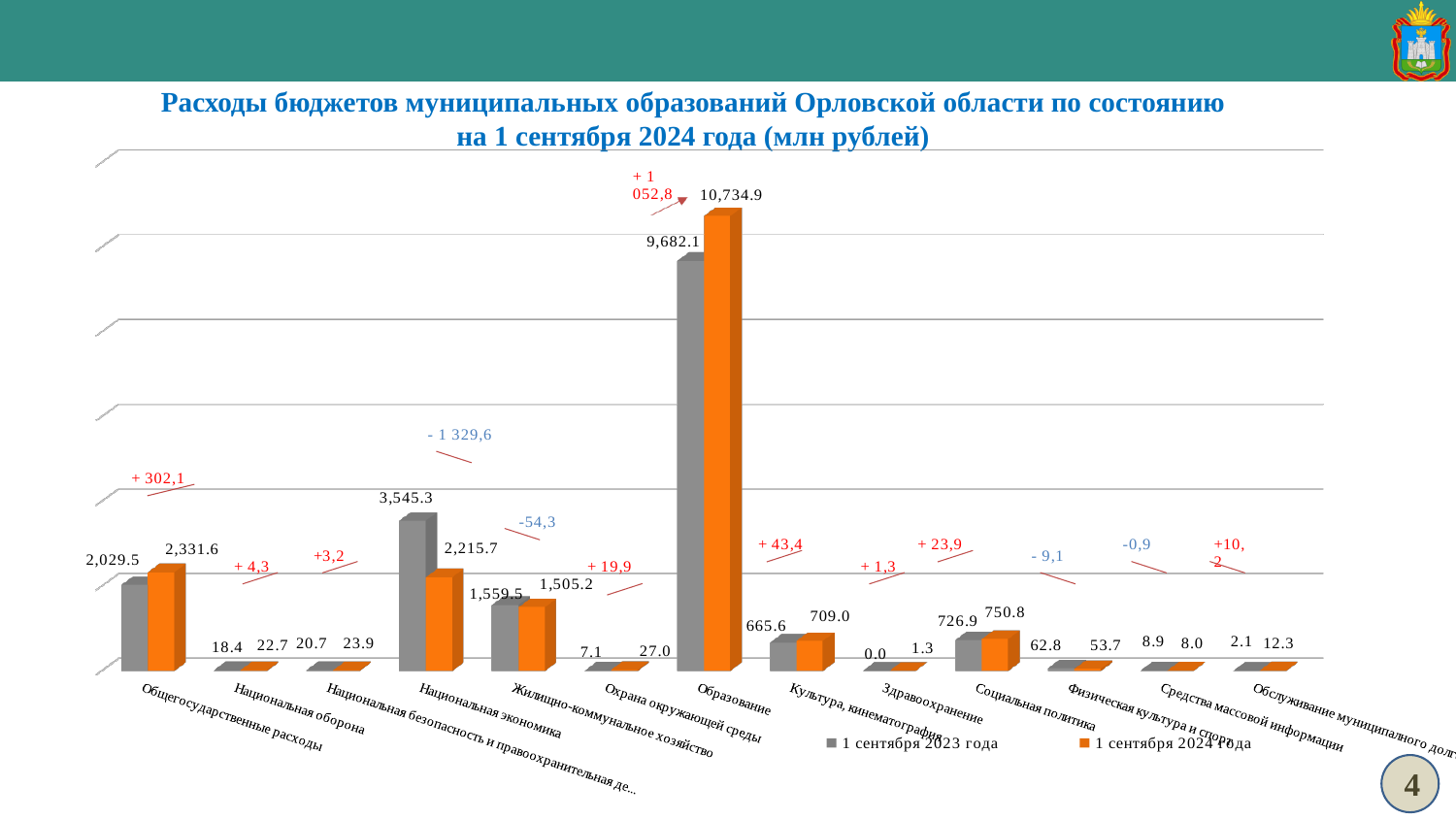
How many series does the legend list? 2 What is the difference between the 2023 and 2024 values for Национальная экономика? 1,329.6 What is the difference between the 2024 and 2023 values for Общегосударственные расходы? 302.1 What is the value for Образование for 1 сентября 2024 года? 10,734.9 Which is larger for Жилищно-коммунальное хозяйство: the 1 сентября 2023 года value or the 1 сентября 2024 года value? 1 сентября 2023 года What is the value for Здравоохранение for 1 сентября 2023 года? 0.0 What is the value for Национальная экономика for 1 сентября 2023 года? 3,545.3 Which category has the lowest value for 1 сентября 2023 года? Здравоохранение What kind of chart is shown on the slide? Bar chart Which colour represents the series 1 сентября 2024 года? Orange Which category has the highest value for 1 сентября 2024 года? Образование How many categories are shown on the x axis? 13